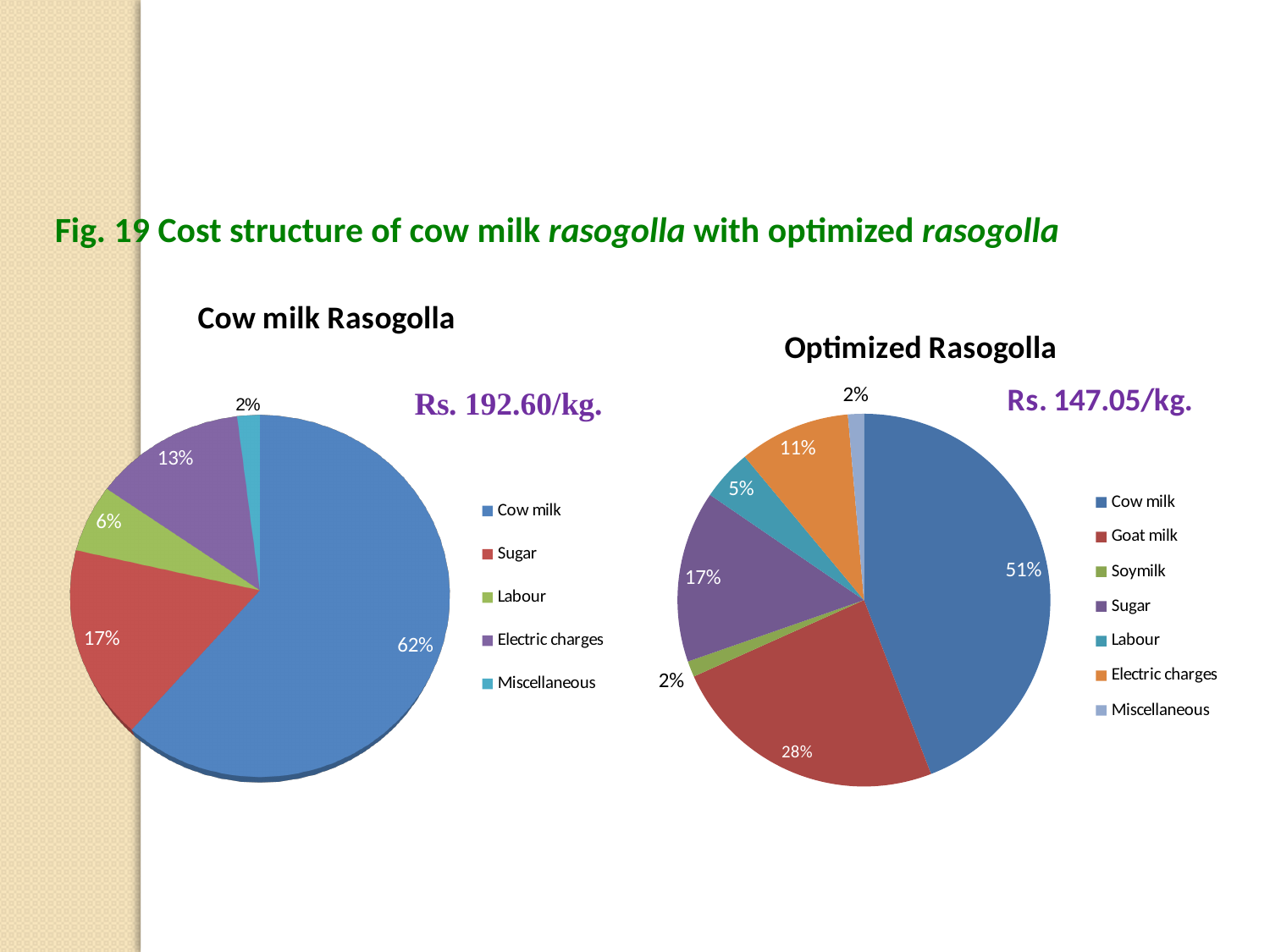
In the "Cow milk Rasogolla" chart, what share does Electric charges have? 13% In the "Cow milk Rasogolla" chart, how many categories does the legend list? 5 In the "Optimized Rasogolla" chart, what share does Goat milk have? 28% In the "Optimized Rasogolla" chart, which category has the largest share? Cow milk In the "Cow milk Rasogolla" chart, what is the difference between the Sugar share and the Labour share? 11% In the "Optimized Rasogolla" chart, how many categories does the legend list? 7 In the "Optimized Rasogolla" chart, what share does Electric charges have? 11% What kind of chart is the "Cow milk Rasogolla" chart? Pie chart In the "Cow milk Rasogolla" chart, which category has the smallest share? Miscellaneous Which is larger: the Sugar share in the "Optimized Rasogolla" chart or the Labour share in the same chart? Sugar What cost per kg is printed next to the "Optimized Rasogolla" chart? Rs. 147.05/kg.